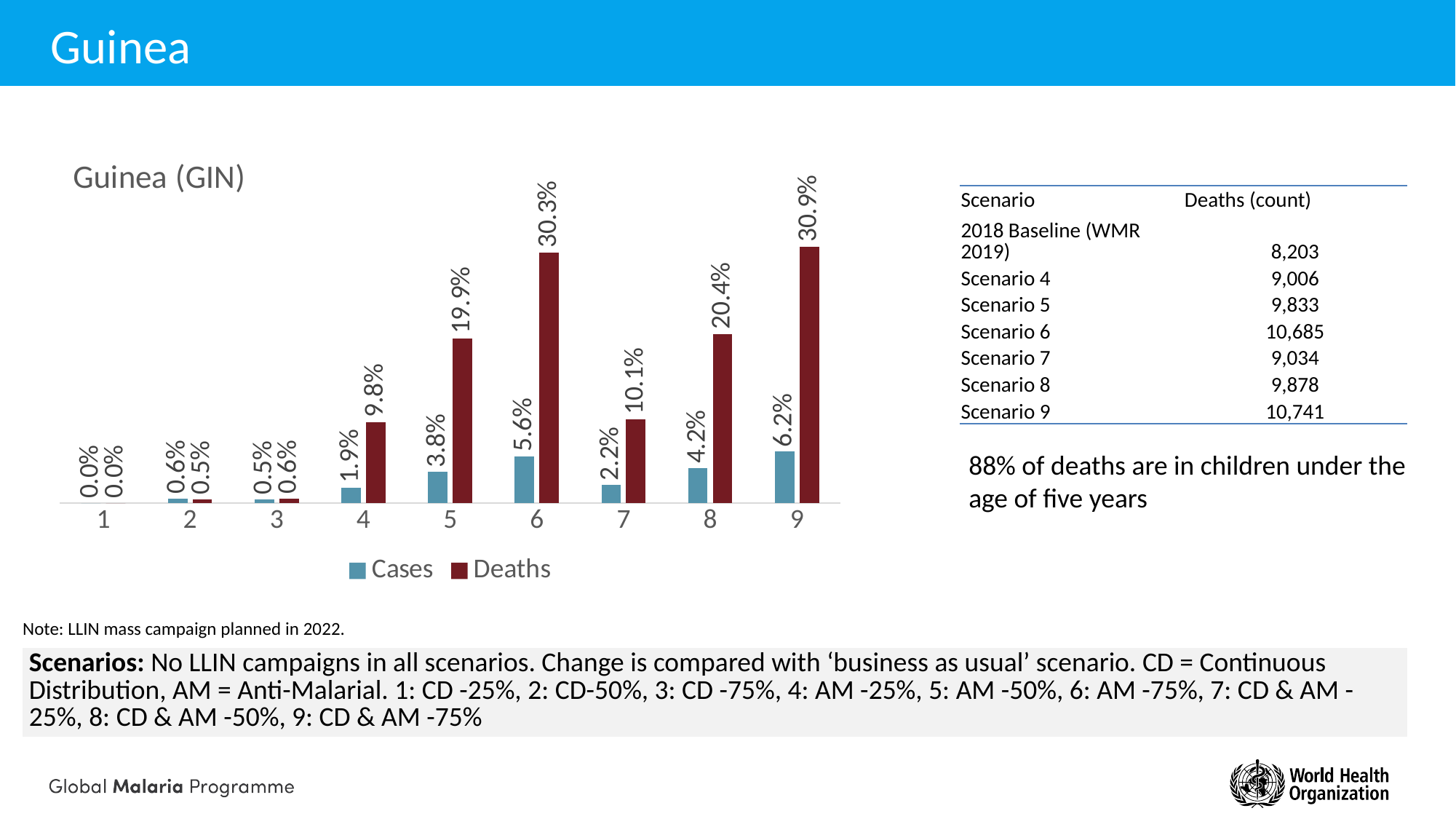
How many scenarios are shown on the x axis of the Guinea (GIN) chart? 9 What are the two series named in the legend of the Guinea (GIN) chart? Cases and Deaths Which scenario has the highest Cases value in the Guinea (GIN) chart? 9 What kind of chart is the Guinea (GIN) chart? bar chart What is the Cases value for scenario 6 in the Guinea (GIN) chart? 5.6% Which scenario has the lowest Deaths value in the Guinea (GIN) chart? 1 What is the Deaths value for scenario 9 in the Guinea (GIN) chart? 30.9% Which scenario has the highest Deaths value in the Guinea (GIN) chart? 9 What is the difference between the Deaths values for scenario 8 and scenario 4 in the Guinea (GIN) chart? 10.6% What is the Deaths value for scenario 5 in the Guinea (GIN) chart? 19.9% In the Guinea (GIN) chart, is the Deaths value for scenario 6 larger or smaller than the Deaths value for scenario 7? larger How many series does the legend of the Guinea (GIN) chart list? 2